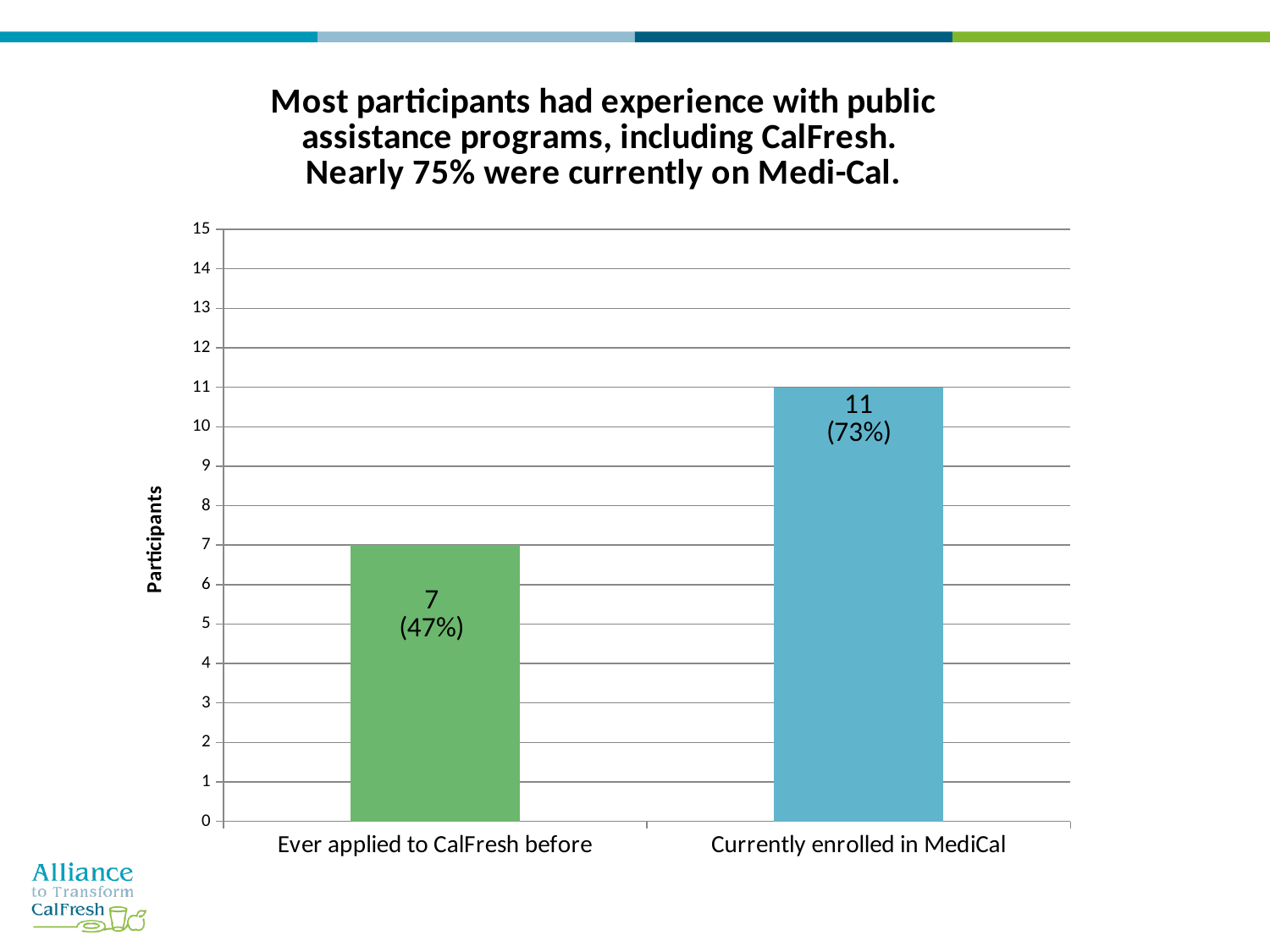
Which category has the lower number of participants? Ever applied to CalFresh before How many categories are shown on the chart? 2 Is the number of participants currently enrolled in MediCal greater or less than 10? greater What kind of chart is shown on the slide? Bar chart What percentage of participants had ever applied to CalFresh before? 47% What is the label on the vertical axis of the chart? Participants How many participants had ever applied to CalFresh before? 7 What is the difference in participants between those currently enrolled in MediCal and those who ever applied to CalFresh before? 4 How many participants were currently enrolled in MediCal? 11 What percentage of participants were currently enrolled in MediCal? 73% What colour is the bar for 'Currently enrolled in MediCal'? Blue Which category has the higher number of participants? Currently enrolled in MediCal